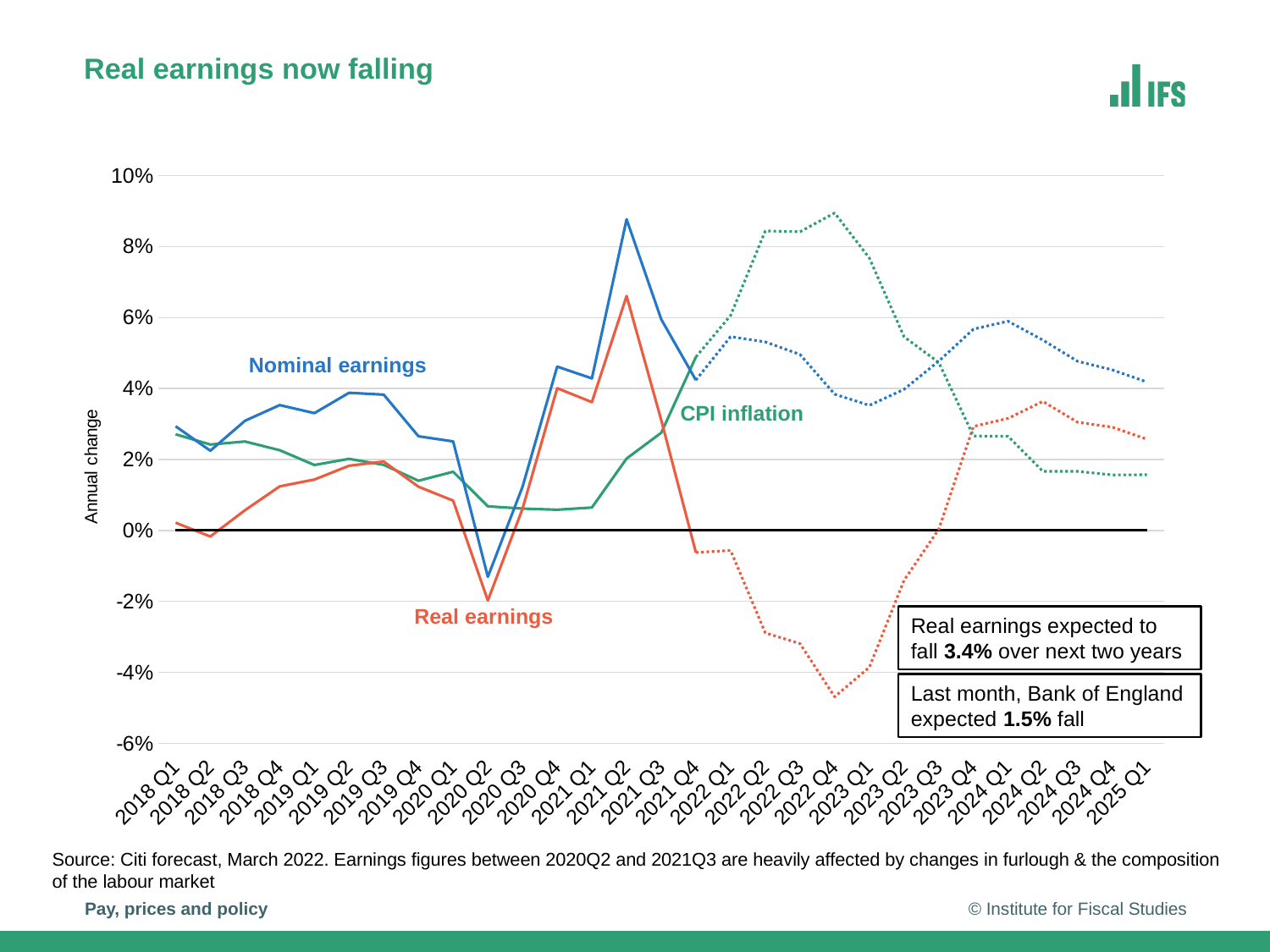
Is the value for Real earnings in 2022 Q4 greater or less than -4%? less In 2021 Q2, which is larger: Nominal earnings or CPI inflation? Nominal earnings What is the label on the vertical axis of the chart? Annual change Is the value for Nominal earnings in 2021 Q2 greater or less than 8%? greater How many series are plotted on the chart? 3 How many quarters are shown along the x axis of the chart? 29 What kind of chart is shown on the slide? Line chart Is the value for CPI inflation in 2025 Q1 greater or less than 2%? less Does the Real earnings line rise or fall between 2021 Q2 and 2022 Q4? Fall Which series has the highest value in 2022 Q4? CPI inflation